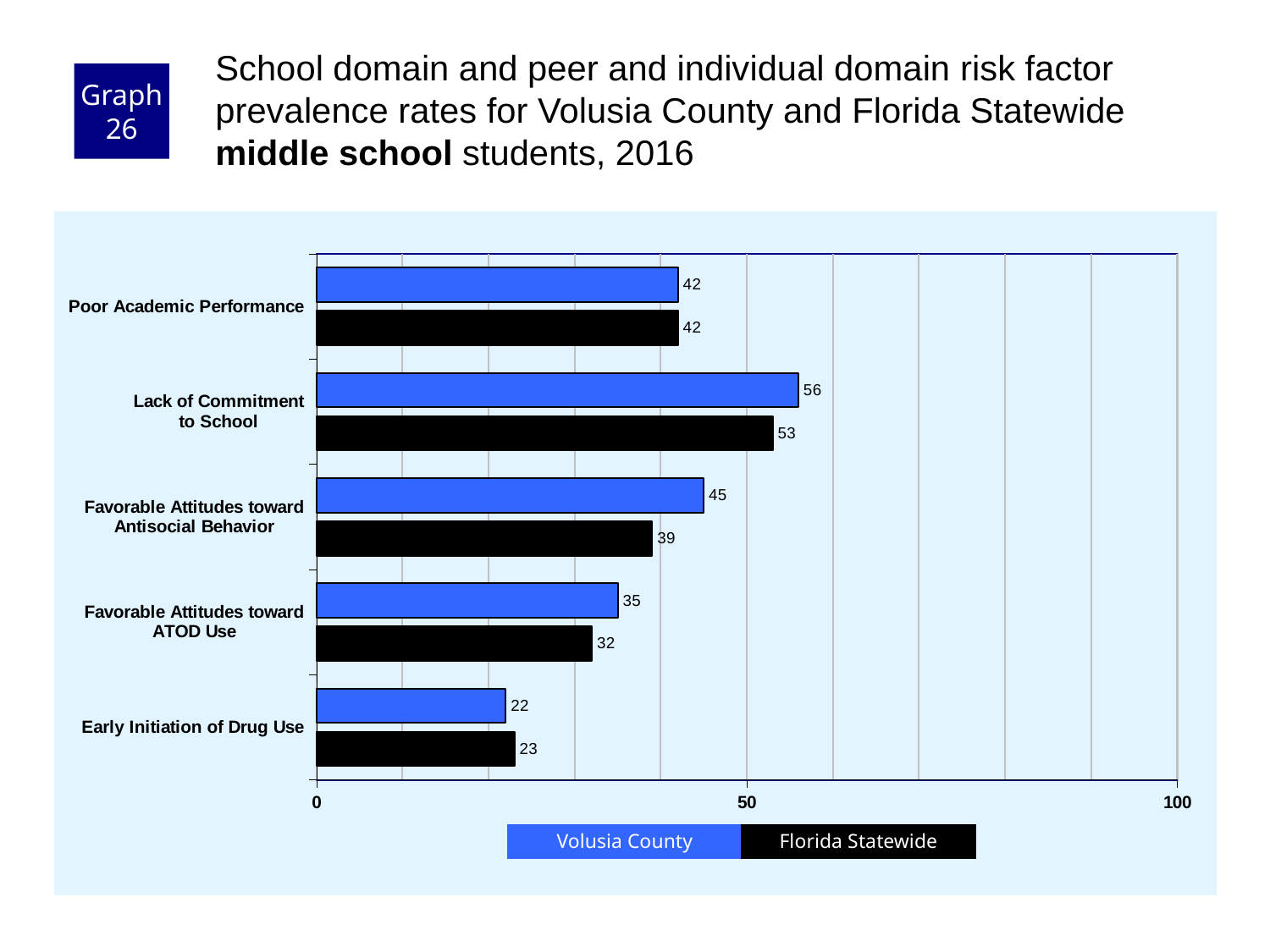
What is the Florida Statewide value for Favorable Attitudes toward Antisocial Behavior? 39 Which risk factor has the lowest Florida Statewide value? Early Initiation of Drug Use Which colour represents Florida Statewide in the chart? black What is the Volusia County value for Lack of Commitment to School? 56 What is the Florida Statewide value for Early Initiation of Drug Use? 23 Which is larger for Favorable Attitudes toward ATOD Use: the Volusia County value or the Florida Statewide value? Volusia County What kind of chart is shown on the slide? bar chart Which risk factor has the highest Volusia County value? Lack of Commitment to School What is the difference between the Volusia County and Florida Statewide values for Favorable Attitudes toward Antisocial Behavior? 6 How many risk factor categories are shown on the chart? 5 How many series does the legend list? 2 Is the Florida Statewide value for Lack of Commitment to School greater or less than 50? greater